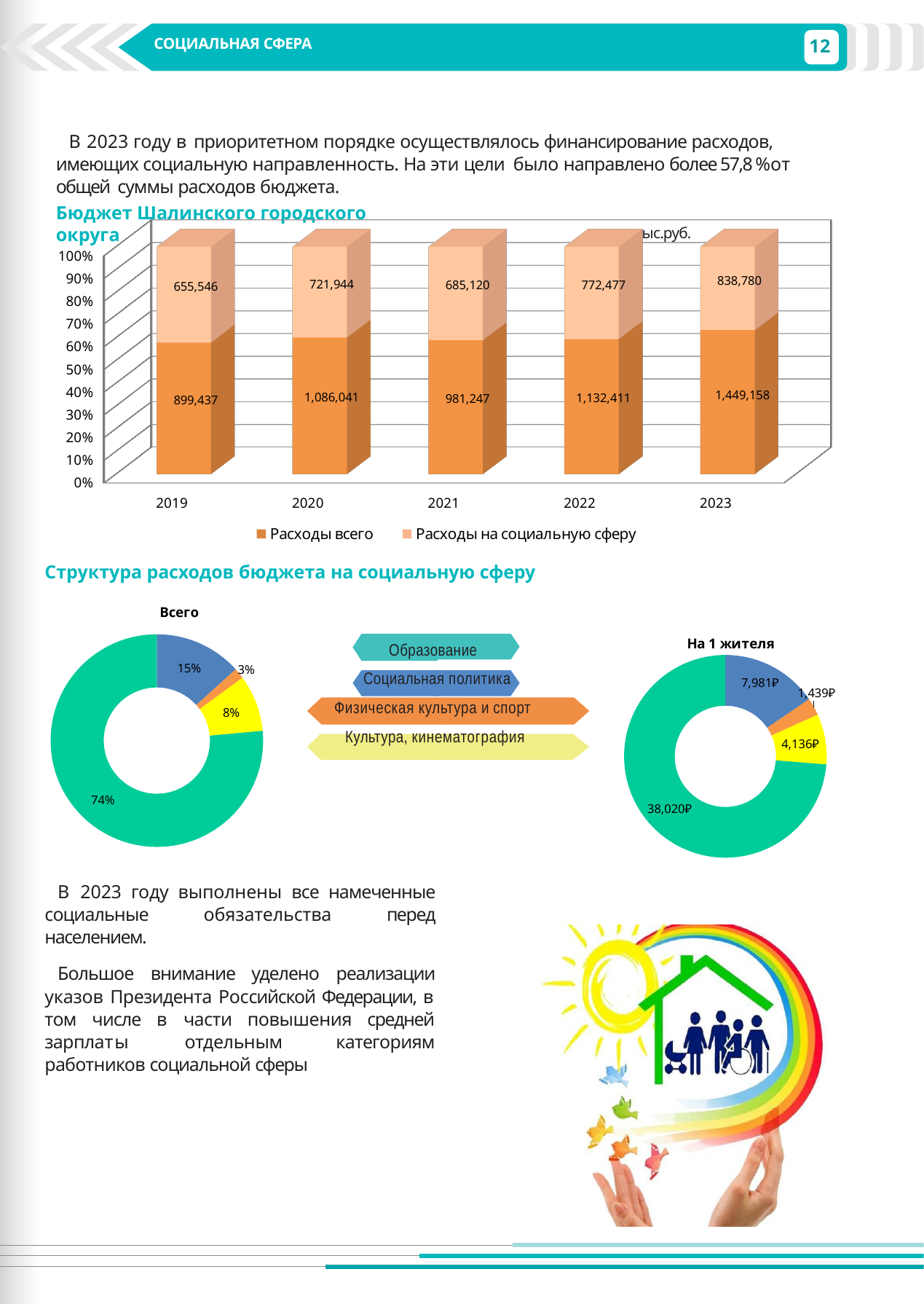
In the chart 'Бюджет Шалинского городского округа', which year has the lowest value of 'Расходы на социальную сферу'? 2019 What type of chart is 'Бюджет Шалинского городского округа'? Stacked bar chart In the chart 'Бюджет Шалинского городского округа', what is the difference between 'Расходы всего' in 2023 and in 2022? 316,747 In the doughnut chart 'На 1 жителя', which category has the smallest value? Физическая культура и спорт In the chart 'Бюджет Шалинского городского округа', which year has the highest value of 'Расходы всего'? 2023 In the chart 'Бюджет Шалинского городского округа', how many series does the legend list? 2 In the chart 'Бюджет Шалинского городского округа', what is the value of 'Расходы всего' for 2023? 1,449,158 In the doughnut chart 'Всего', which is larger: 'Социальная политика' or 'Культура, кинематография'? Социальная политика In the doughnut chart 'Всего', what share does 'Образование' have? 74% In the doughnut chart 'На 1 жителя', what is the value for 'Образование'? 38,020₽ In the chart 'Бюджет Шалинского городского округа', what is the value of 'Расходы на социальную сферу' for 2021? 685,120 In the chart 'Бюджет Шалинского городского округа', how many years are shown on the x axis? 5